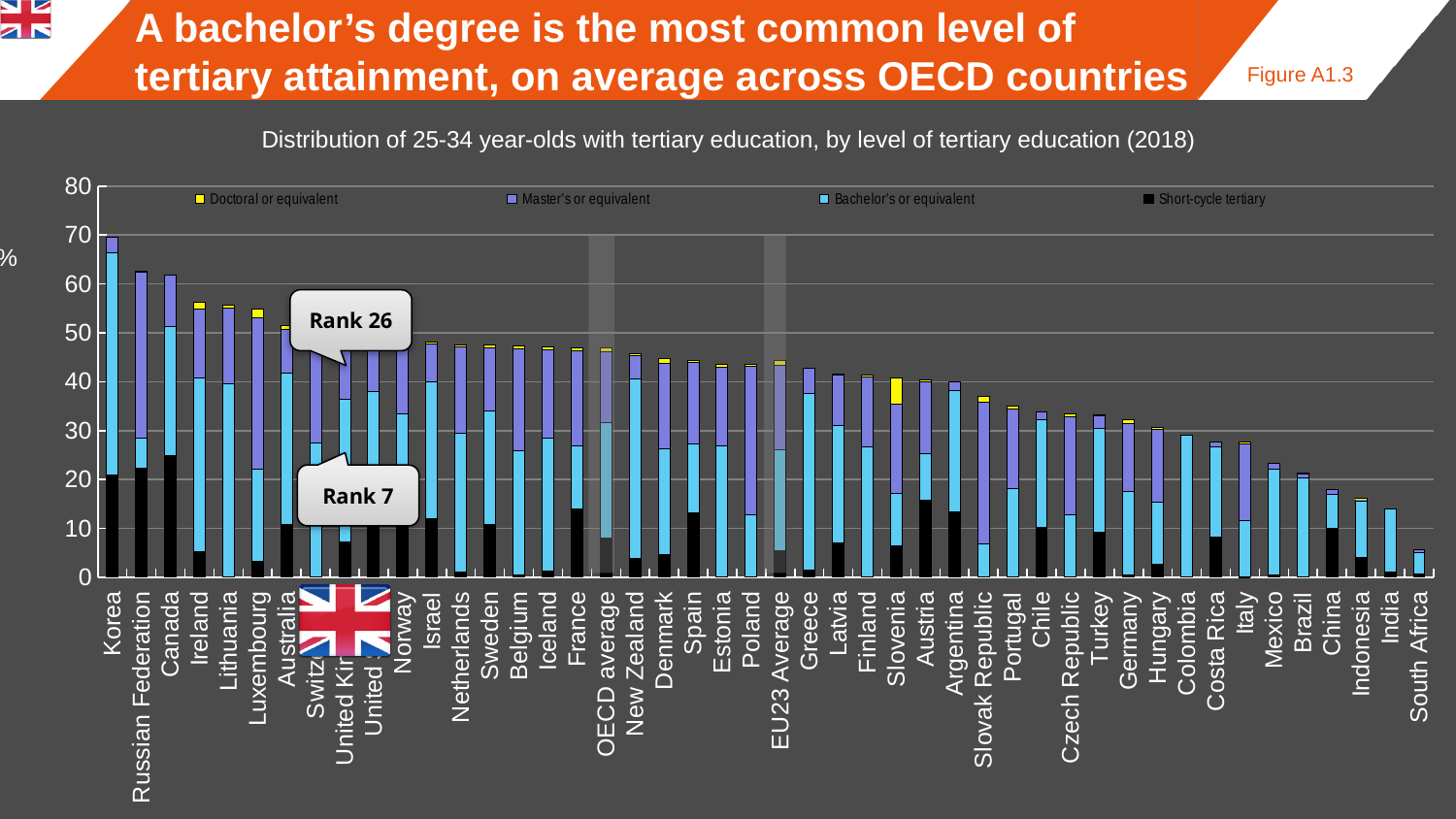
Which legend entry is shown in yellow? Doctoral or equivalent How many series does the legend list? 4 Is the total value for India greater or less than 20? less Which country has the highest total share of 25-34 year-olds with tertiary education? Korea Is the total value for Korea greater or less than 60? greater Is the total value for the OECD average greater or less than 40? greater What kind of chart is shown on the slide? Stacked bar chart Which country has the lowest total share of 25-34 year-olds with tertiary education? South Africa What is the subtitle describing the chart's data? Distribution of 25-34 year-olds with tertiary education, by level of tertiary education (2018) Do the total values generally rise or fall moving from left to right along the x axis? Fall Which has a larger total value, Canada or Italy? Canada